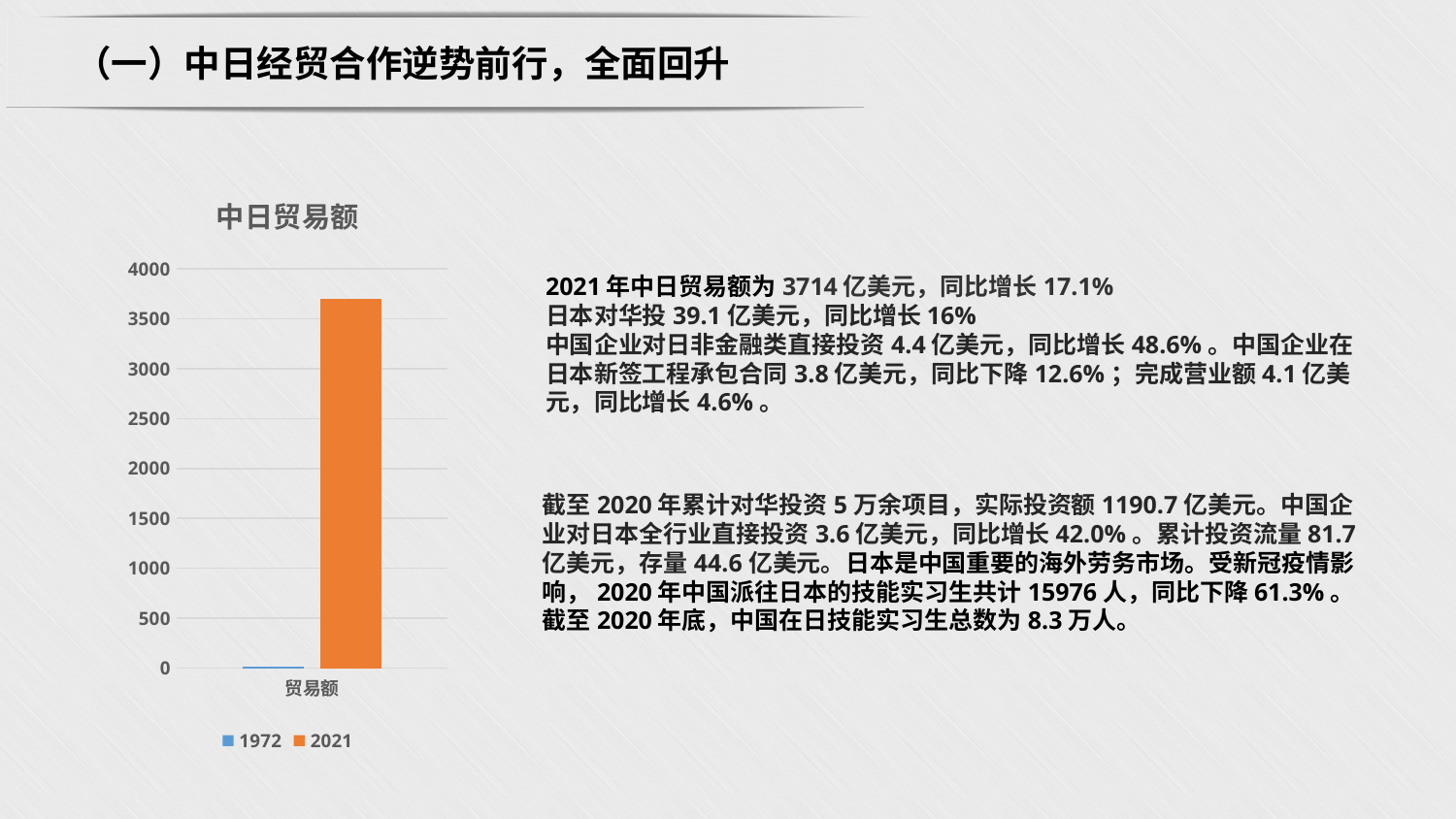
Which series are listed in the chart legend? 1972 and 2021 Is the value for 2021 greater or less than 3500? greater Which series has the lowest value in the chart? 1972 What kind of chart is shown on the slide? bar chart Is the value for 1972 greater or less than 500? less How many categories are shown on the x axis of the chart? 1 What is the title of the chart? 中日贸易额 Which series has the higher value for 贸易额, 1972 or 2021? 2021 How many series does the chart legend list? 2 What is the highest value shown on the y axis of the chart? 4000 What is the category label on the x axis of the chart? 贸易额 Is the value for 2021 greater or less than 4000? less